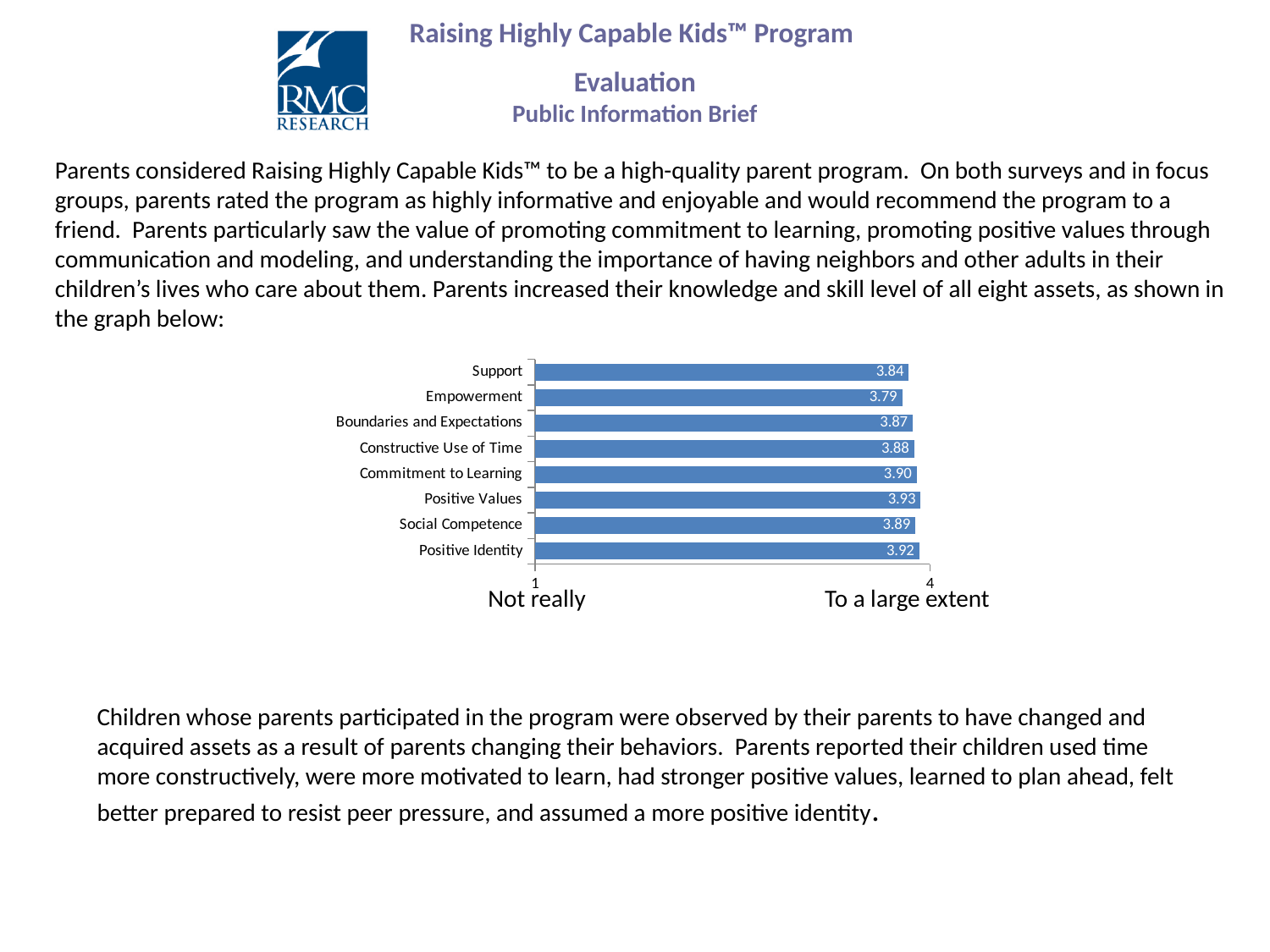
What is the value for Empowerment? 3.79 What is the value for Constructive Use of Time? 3.88 Which category has the highest value? Positive Values Which category has the lowest value? Empowerment Which is larger, the value for Commitment to Learning or the value for Boundaries and Expectations? Commitment to Learning What is the value for Social Competence? 3.89 How many categories are shown in the chart? 8 What is the value for Positive Identity? 3.92 What label appears at the right end of the chart's axis, under the value 4? To a large extent What kind of chart is shown on the slide? Bar chart What is the value for Support? 3.84 What is the difference between the values for Positive Values and Empowerment? 0.14